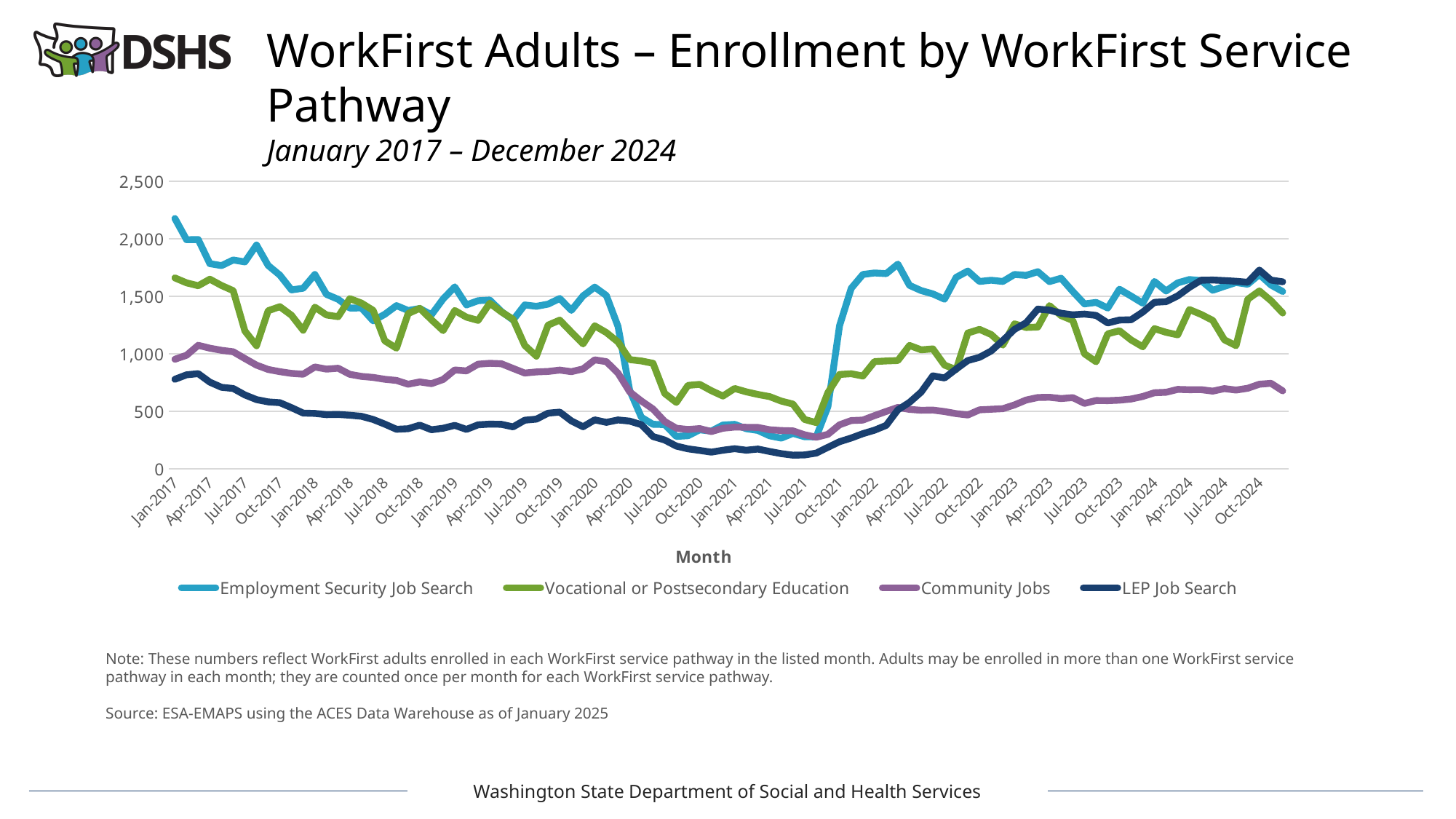
Is the value for Vocational or Postsecondary Education in Jul-2021 greater or less than 1,000? less In Oct-2024, which series has the higher value: Community Jobs or Vocational or Postsecondary Education? Vocational or Postsecondary Education What are the four series listed in the legend? Employment Security Job Search, Vocational or Postsecondary Education, Community Jobs, LEP Job Search Is the value for Employment Security Job Search in Jan-2017 greater or less than 2,000? greater Is the value for LEP Job Search in Jul-2021 greater or less than 500? less Does the LEP Job Search series generally rise or fall from Jul-2021 to Oct-2024? rise What kind of chart is shown on the slide? line chart Does the Employment Security Job Search series generally rise or fall from Jan-2017 to Jul-2020? fall In Jan-2017, which series has the higher value: Employment Security Job Search or LEP Job Search? Employment Security Job Search How many series does the legend list? 4 What is the title of the x axis? Month